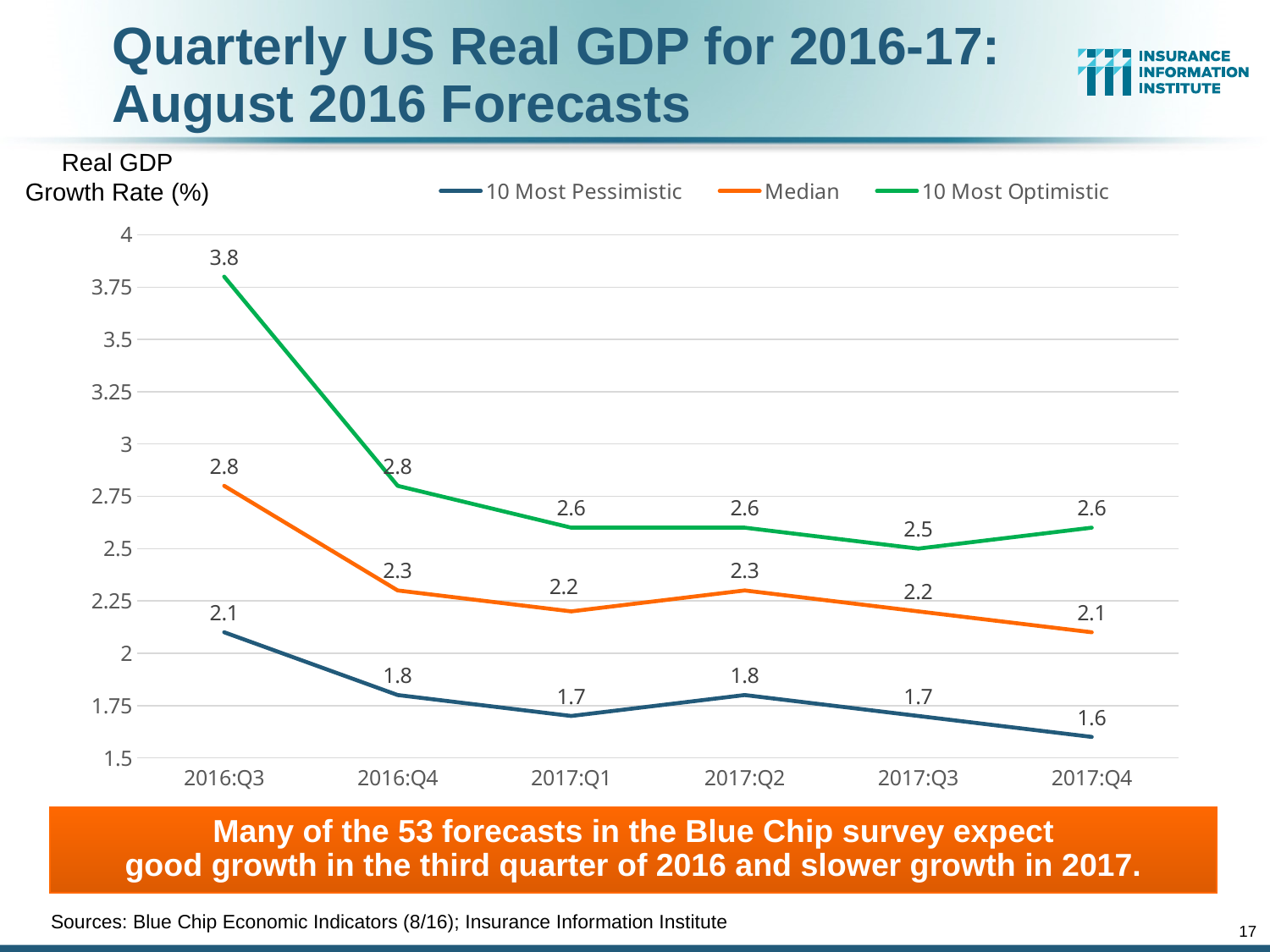
What colour is the line for the 10 Most Optimistic series? Green What kind of chart is shown on the slide? Line chart How many series does the legend list? 3 How many quarters are shown on the x axis? 6 What is the 10 Most Pessimistic forecast for 2017:Q4? 1.6 In which quarter is the 10 Most Pessimistic forecast lowest? 2017:Q4 What is the 10 Most Optimistic forecast for 2016:Q3? 3.8 Does the Median forecast rise or fall from 2016:Q3 to 2017:Q4? Fall In which quarter is the 10 Most Optimistic forecast highest? 2016:Q3 Which is larger, the Median forecast for 2016:Q4 or the Median forecast for 2017:Q4? 2016:Q4 What is the difference between the 10 Most Optimistic and 10 Most Pessimistic forecasts for 2016:Q3? 1.7 What is the Median forecast for 2017:Q2? 2.3